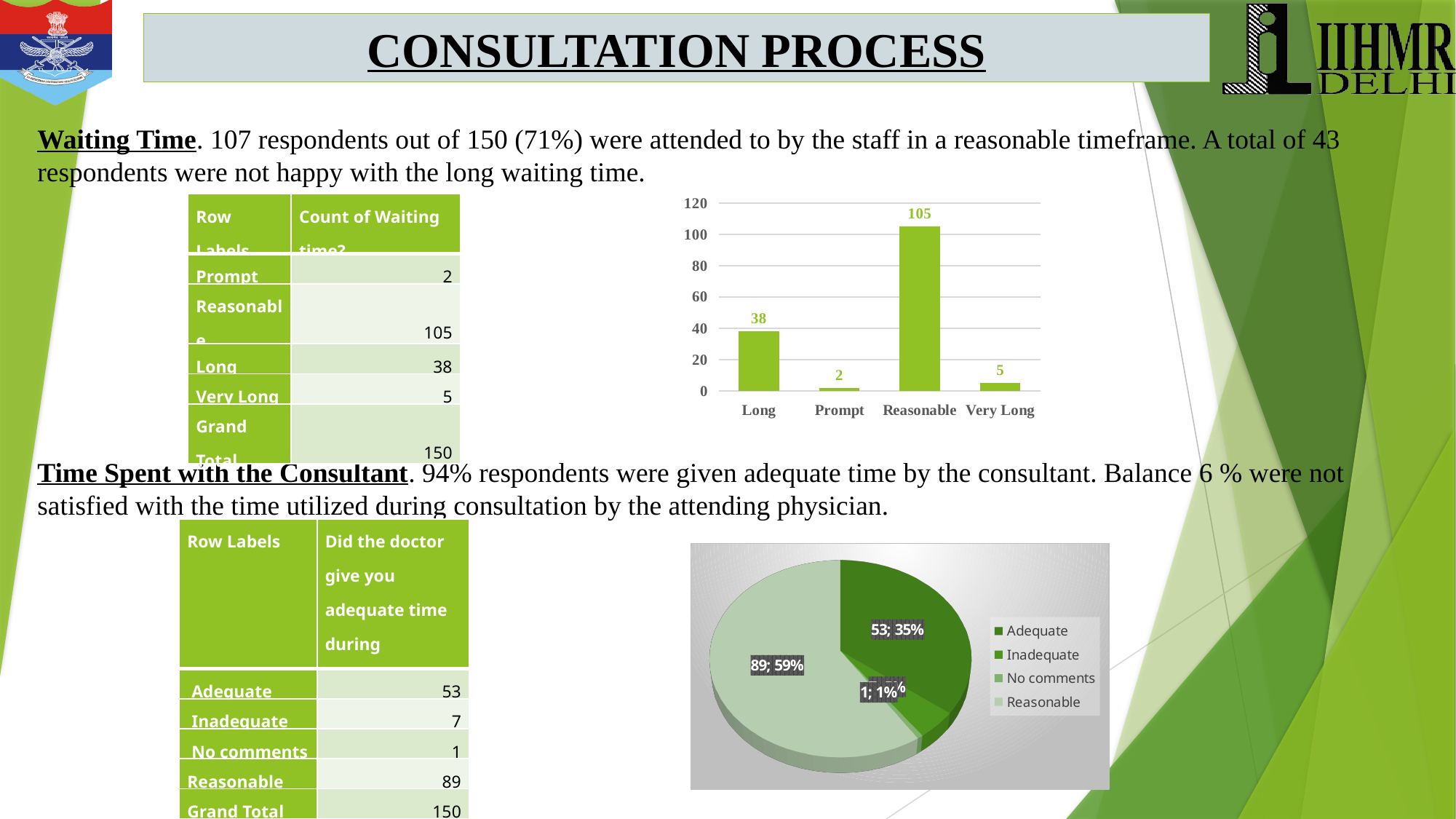
In the top bar chart, which category has the highest value? Reasonable In the top bar chart, which is larger, the value for Very Long or the value for Prompt? Very Long In the top bar chart, what is the value for Reasonable? 105 How many entries does the legend of the bottom pie chart list? 4 In the top bar chart, what is the value for Long? 38 What type of chart is the bottom chart on the slide (time spent with the consultant)? pie chart In the top bar chart, what is the value for Prompt? 2 What type of chart is the top chart on the slide (the waiting time chart)? bar chart How many categories are shown on the x axis of the top bar chart? 4 In the top bar chart, which category has the lowest value? Prompt In the top bar chart, what is the difference between the values for Reasonable and Long? 67 In the bottom pie chart, what share does the Reasonable slice represent? 59%